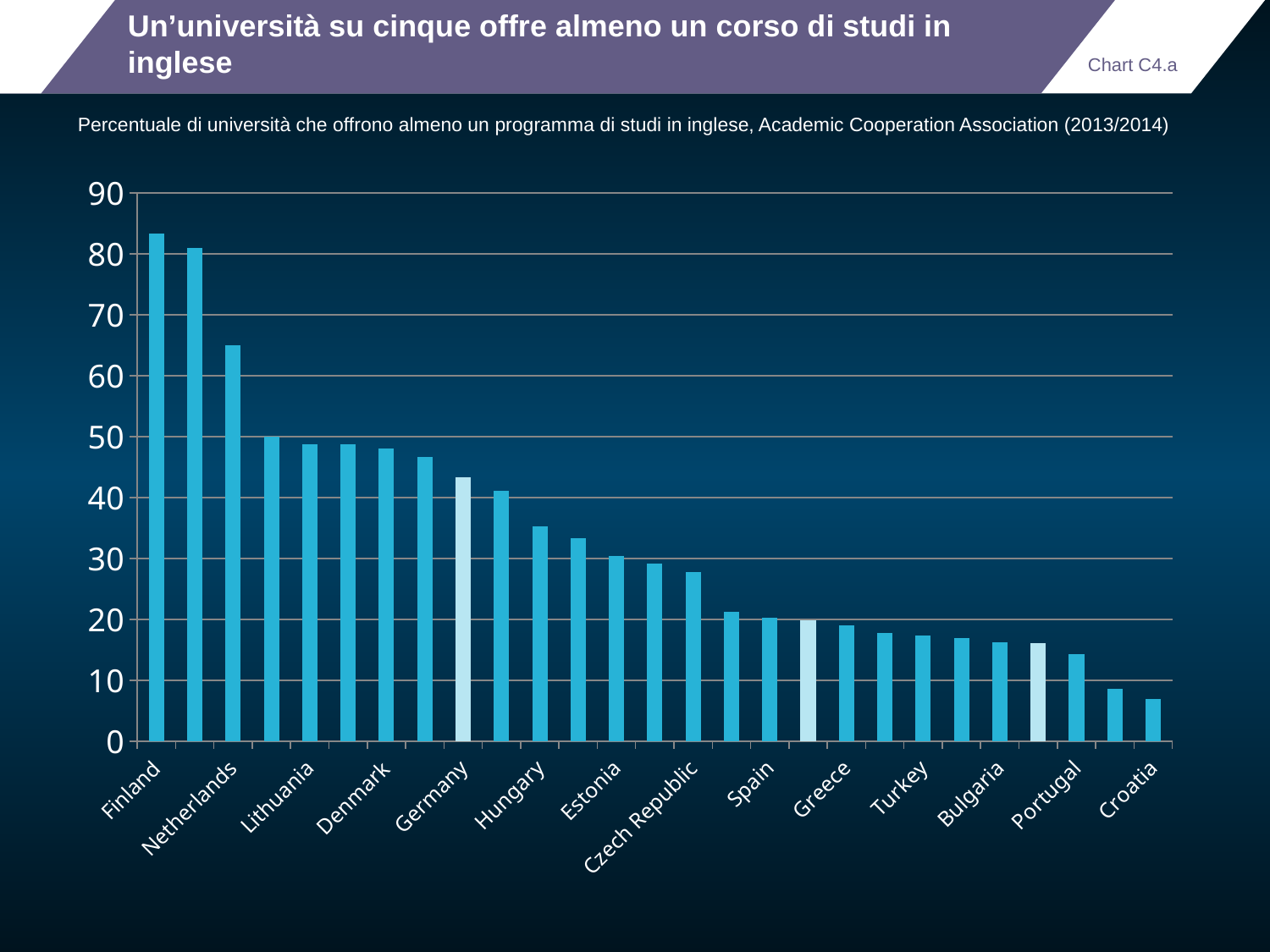
What kind of chart is shown on the slide? bar chart Is the value for Finland greater or less than 80? greater What is the title of the slide containing the chart? Un'università su cinque offre almeno un corso di studi in inglese Is the value for Germany greater or less than 40? greater Is the value for Hungary greater or less than 30? greater Do the values rise or fall moving from left to right along the x axis? fall Which labelled country has the lowest value in the chart? Croatia Which country has the highest percentage of universities offering at least one programme in English? Finland Which has a higher value, Finland or Netherlands? Finland